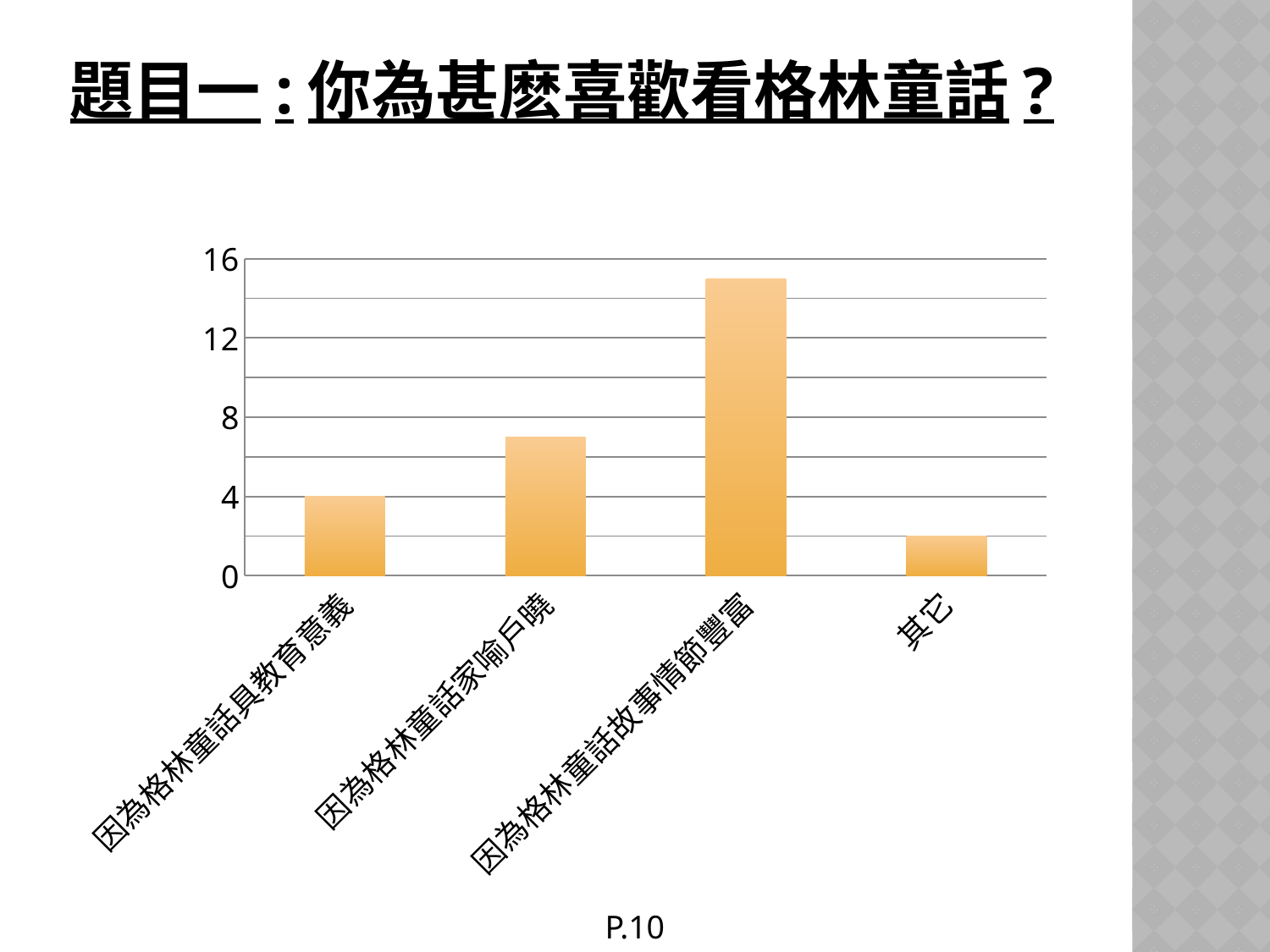
Which is larger, the value for 其它 or the value for 因為格林童話故事情節豐富? 因為格林童話故事情節豐富 What is the title of the slide above the chart? 題目一：你為甚麼喜歡看格林童話？ Which category has the lowest value? 其它 Is the value for 因為格林童話家喻戶曉 greater or less than 8? less Is the value for 其它 greater or less than 4? less What is the value for 因為格林童話具教育意義? 4 What kind of chart is shown on the slide? bar chart Is the value for 因為格林童話家喻戶曉 greater or less than 4? greater How many categories are shown in the chart? 4 Which is larger, the value for 因為格林童話家喻戶曉 or the value for 因為格林童話具教育意義? 因為格林童話家喻戶曉 Which category has the highest value? 因為格林童話故事情節豐富